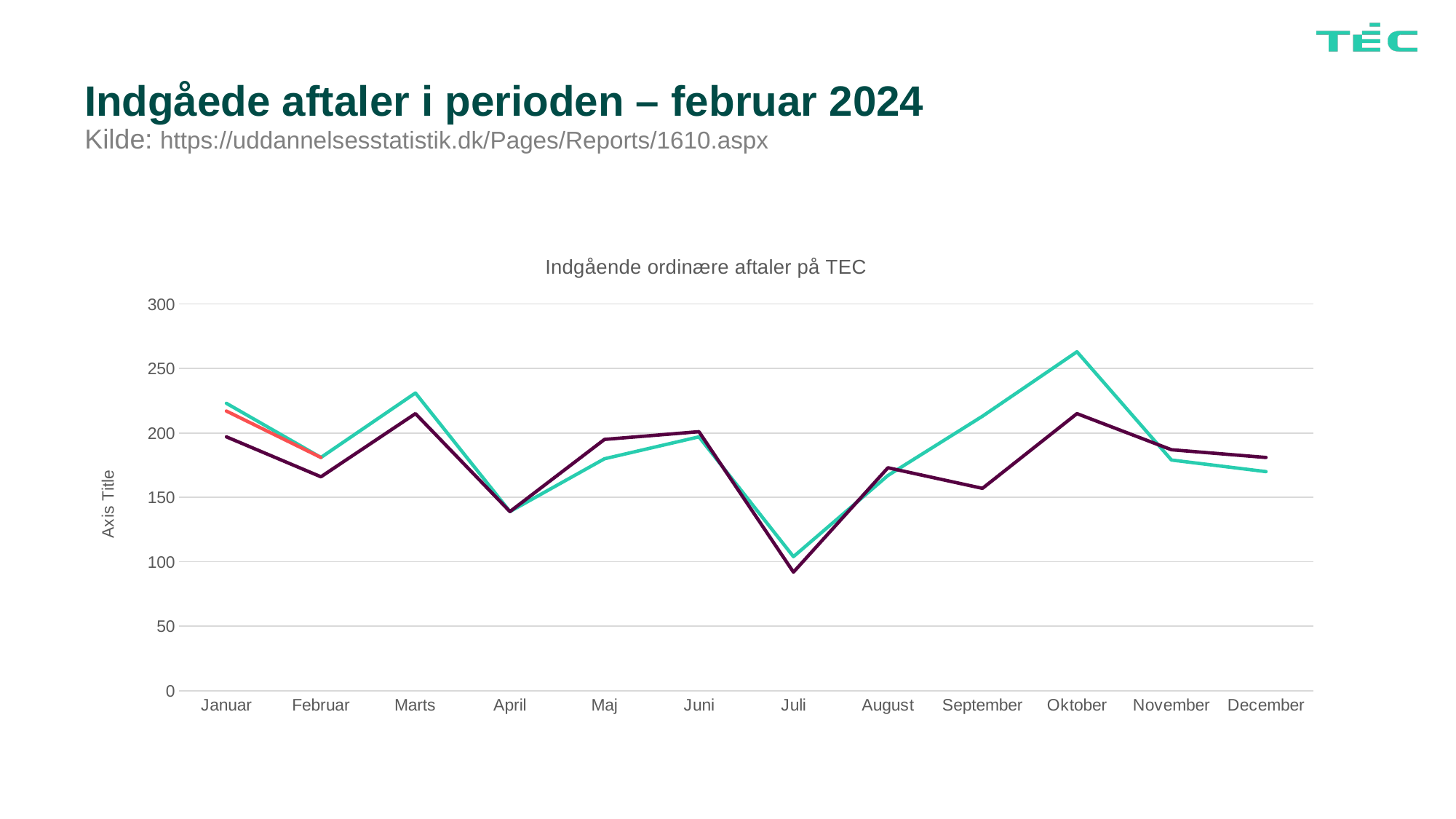
In Oktober, which line has the higher value, the teal (green) line or the dark purple line? The teal (green) line Is the value of the teal (green) line for April greater or less than 150? less What is the title of the chart? Indgående ordinære aftaler på TEC How many months are shown along the x axis of the chart? 12 In which month does the teal (green) line reach its lowest value? Juli What kind of chart is shown on the slide? Line chart Is the value of the dark purple line for Juli greater or less than 100? less In which month does the dark purple line reach its lowest value? Juli In which month does the teal (green) line reach its highest value? Oktober Does the teal (green) line rise or fall from Juni to Juli? Fall Is the value of the teal (green) line for Oktober greater or less than 250? greater